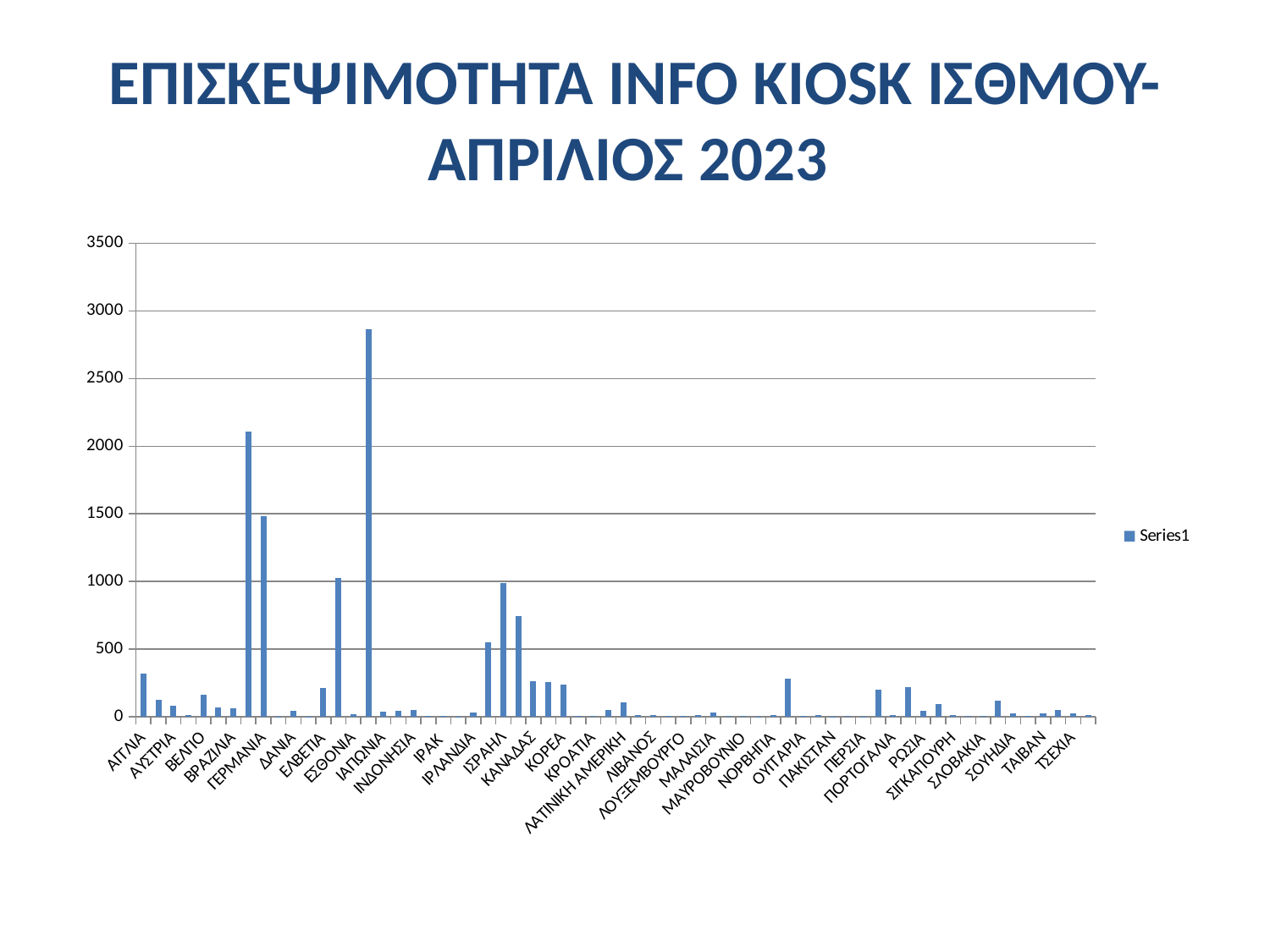
How many series does the legend list? 1 What is the title of the slide? ΕΠΙΣΚΕΨΙΜΟΤΗΤΑ INFO KIOSK ΙΣΘΜΟΥ-ΑΠΡΙΛΙΟΣ 2023 Is the value for ΤΣΕΧΙΑ greater or less than 500? less Is the value for ΑΓΓΛΙΑ greater or less than 100? greater Is the tallest bar in the chart greater or less than 2500? greater Which category label appears last on the horizontal axis? ΤΣΕΧΙΑ What is the name of the series shown in the legend? Series1 What is the highest value shown on the vertical axis? 3500 What kind of chart is shown on the slide? bar chart Which category label appears first on the horizontal axis? ΑΓΓΛΙΑ